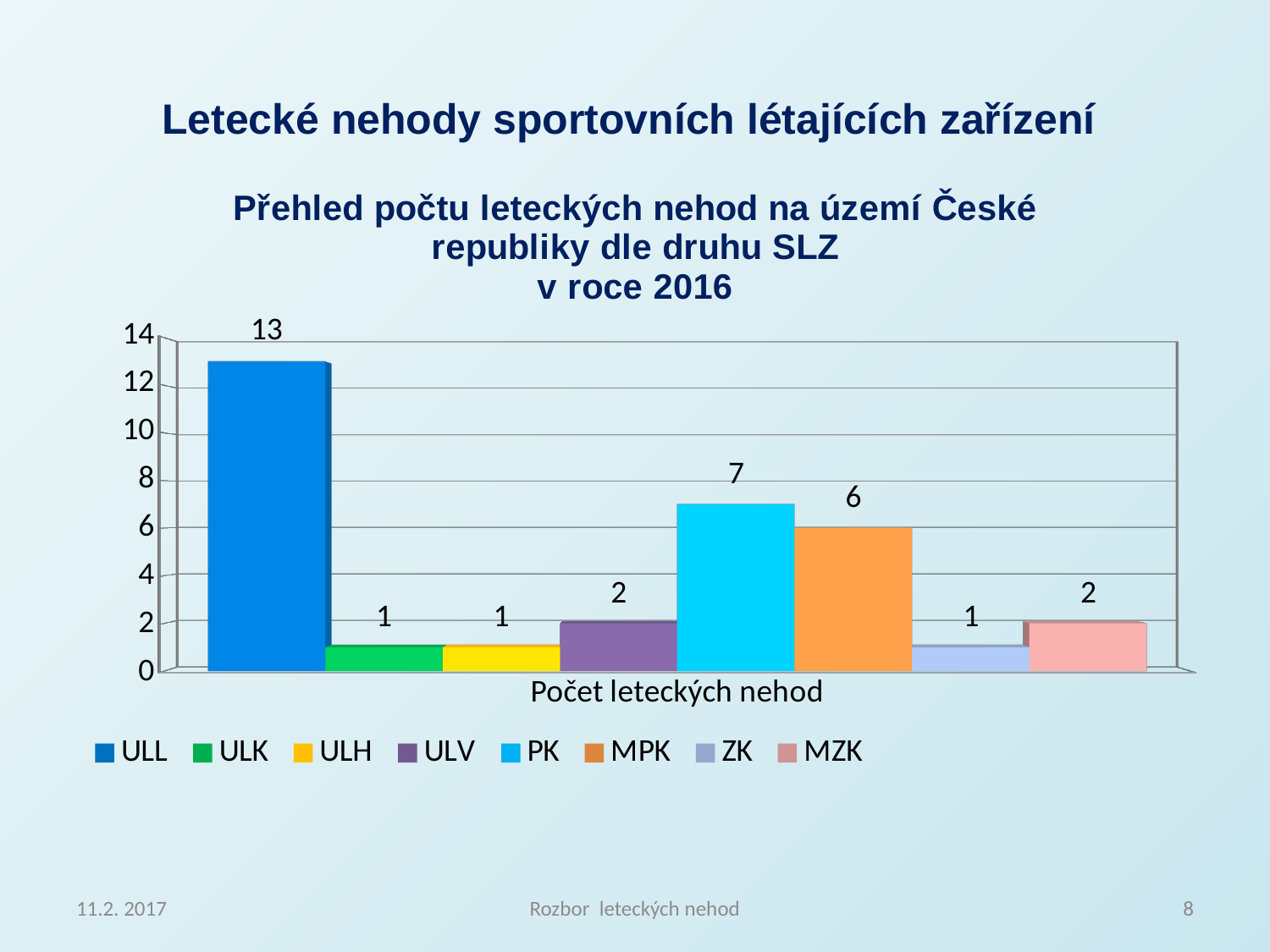
What is the value for ULV? 2 Which series has the highest value? ULL What kind of chart is shown? bar chart What is the value for MPK? 6 What is the difference between the values for MPK and MZK? 4 What is the difference between the values for ULL and PK? 6 Which is larger, the value for PK or the value for MPK? PK What is the label on the x axis of the chart? Počet leteckých nehod Is the value for ULL greater or less than 12? greater What is the value for PK? 7 How many series does the legend list? 8 What is the value for ULL? 13